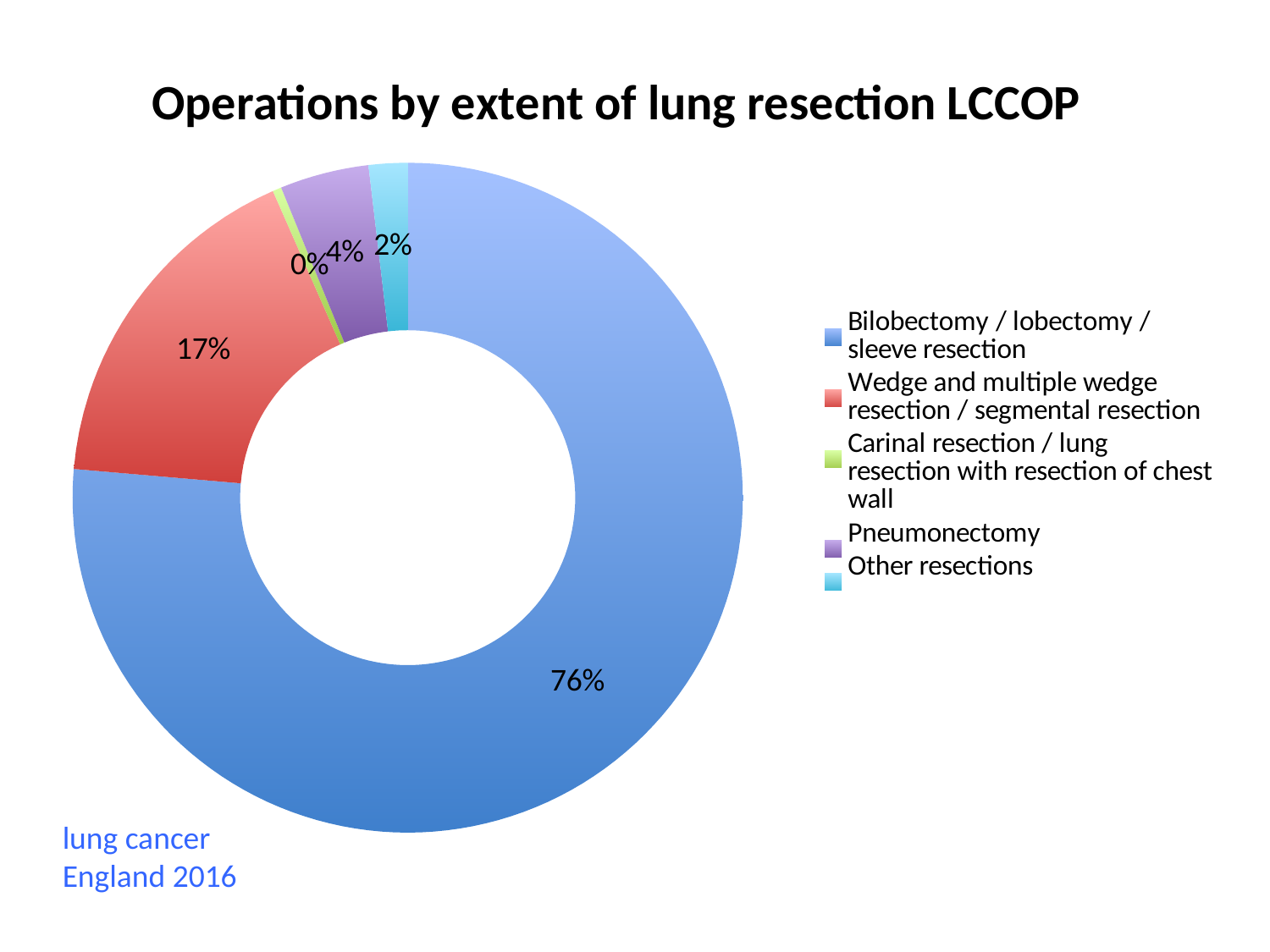
What share of operations is Bilobectomy / lobectomy / sleeve resection? 76% Which has a larger share, Pneumonectomy or Other resections? Pneumonectomy What share of operations is Wedge and multiple wedge resection / segmental resection? 17% What share of operations is Pneumonectomy? 4% Which category has the smallest share of operations? Carinal resection / lung resection with resection of chest wall What share of operations is Other resections? 2% How many categories does the legend list? 5 What kind of chart is shown on the slide? Doughnut (pie) chart What is the difference in percentage points between the Bilobectomy / lobectomy / sleeve resection share and the Wedge and multiple wedge resection / segmental resection share? 59% What share of operations is Carinal resection / lung resection with resection of chest wall? 0% Which category has the largest share of operations? Bilobectomy / lobectomy / sleeve resection What is the title of the chart? Operations by extent of lung resection LCCOP